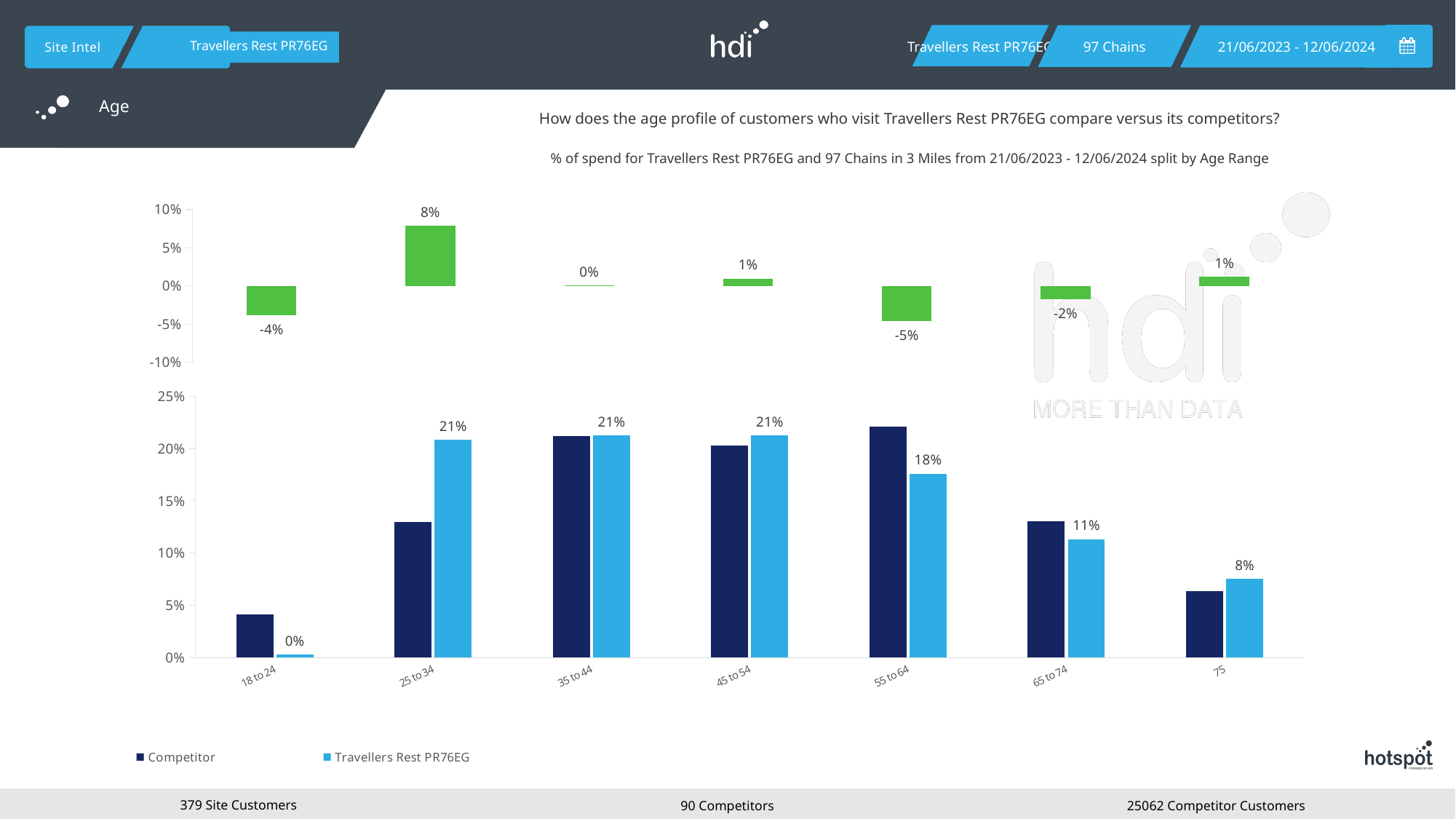
How many series does the legend of the bottom bar chart list? 2 In the bottom bar chart, what is the difference between the Travellers Rest PR76EG values for 55 to 64 and 65 to 74? 7% In the top difference chart, what is the value shown for the 25 to 34 age range? 8% In the top difference chart, which age range has the highest value? 25 to 34 In the top difference chart, which age range has the lowest value? 55 to 64 In the bottom bar chart, what is the value for Travellers Rest PR76EG in the 18 to 24 age range? 0% In the top difference chart, what is the value shown for the 55 to 64 age range? -5% In the bottom bar chart, what is the value for Travellers Rest PR76EG in the 55 to 64 age range? 18% In the bottom bar chart, is the Competitor value for 55 to 64 greater or less than 20%? greater In the bottom bar chart, which is larger for the 25 to 34 age range: the Competitor bar or the Travellers Rest PR76EG bar? Travellers Rest PR76EG In the bottom bar chart, is the Competitor value for 18 to 24 greater or less than 5%? less In the bottom bar chart, what is the value for Travellers Rest PR76EG in the 65 to 74 age range? 11%